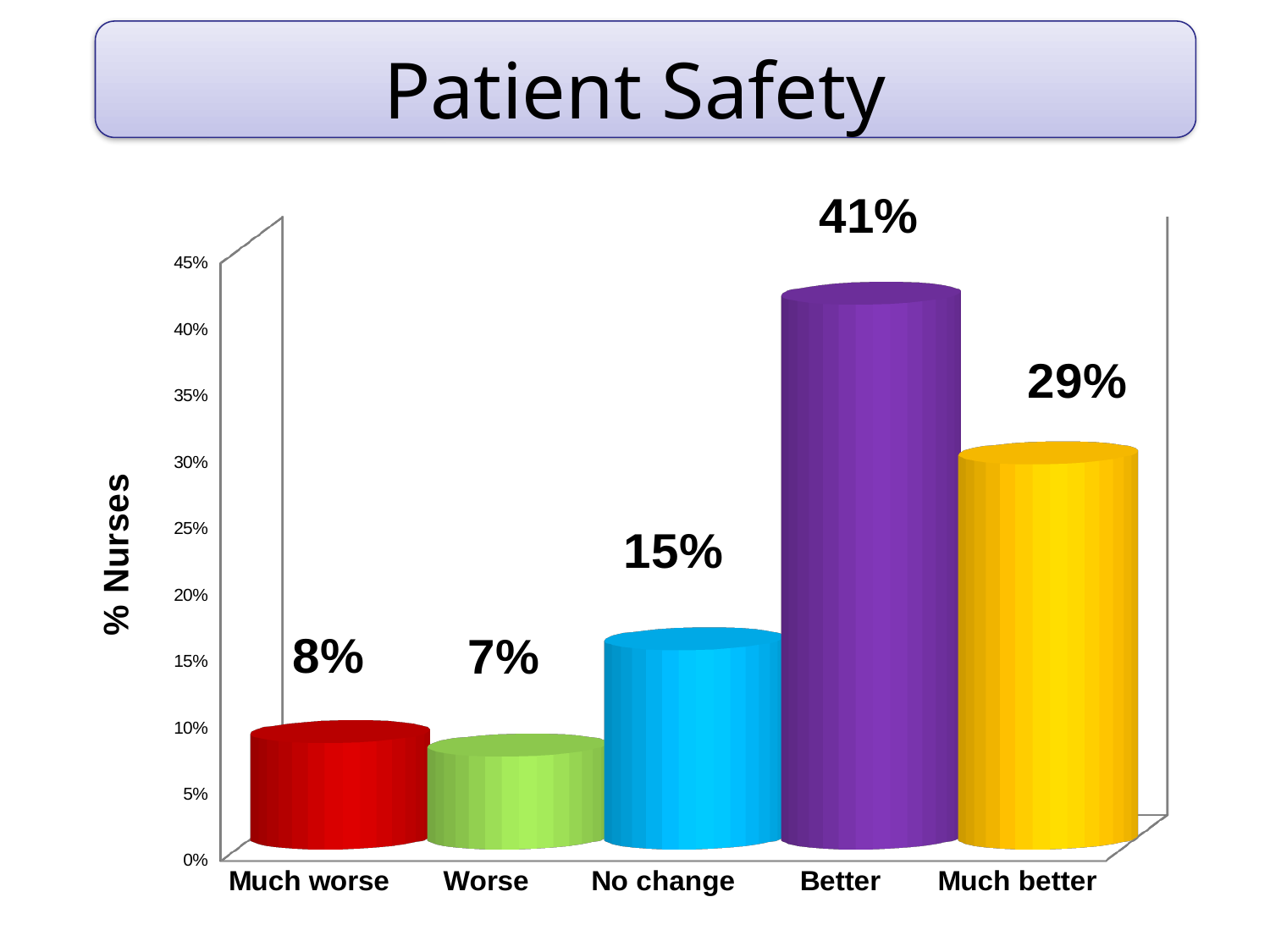
What percentage of nurses answered "Better"? 41% What kind of chart is shown on the slide? bar chart Is the value for "Much better" greater or less than 25%? greater Which is larger, the value for "Much better" or the value for "No change"? Much better What is the value for "Much worse"? 8% Which category has the lowest value? Worse What is the difference between the values for "Better" and "Much better"? 12% What is the label of the vertical axis? % Nurses Which category has the highest value? Better What is the value for "No change"? 15% What is the difference between the values for "No change" and "Worse"? 8% How many categories are shown on the x axis? 5